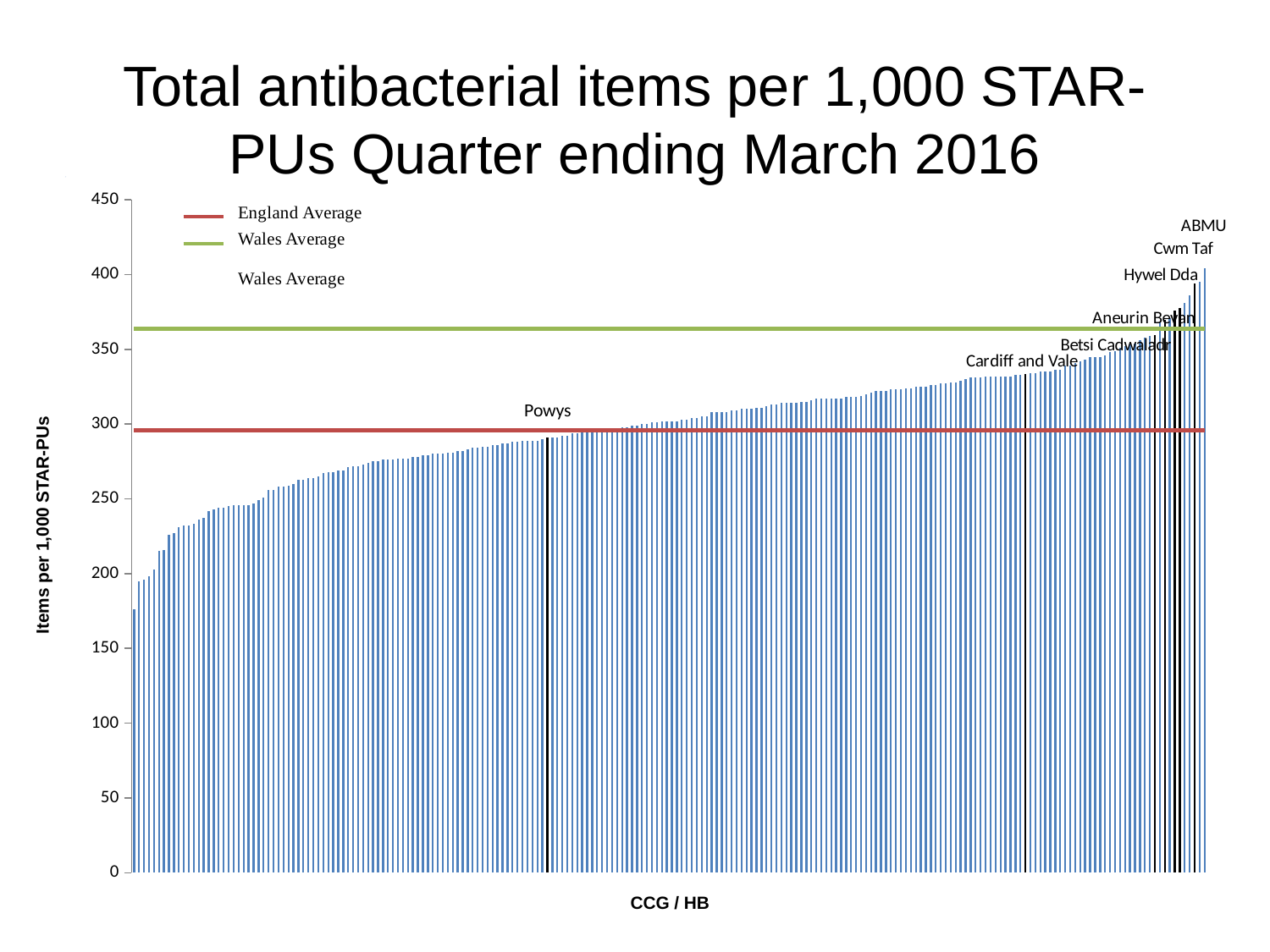
Which is larger, the value for ABMU or the value for Powys? ABMU Is the value for Powys greater or less than 250? greater Is the value for Cardiff and Vale greater or less than 300? greater Is the value for ABMU greater or less than 350? greater Which labelled Welsh health board has the highest value? ABMU Which average line is higher, the England Average or the Wales Average? Wales Average What kind of chart is shown on the slide? bar chart Do the bar values rise or fall from left to right along the x axis? rise Which labelled Welsh health board has the lowest value? Powys Which two average lines does the legend list? England Average and Wales Average What is the title of the chart? Total antibacterial items per 1,000 STAR-PUs Quarter ending March 2016